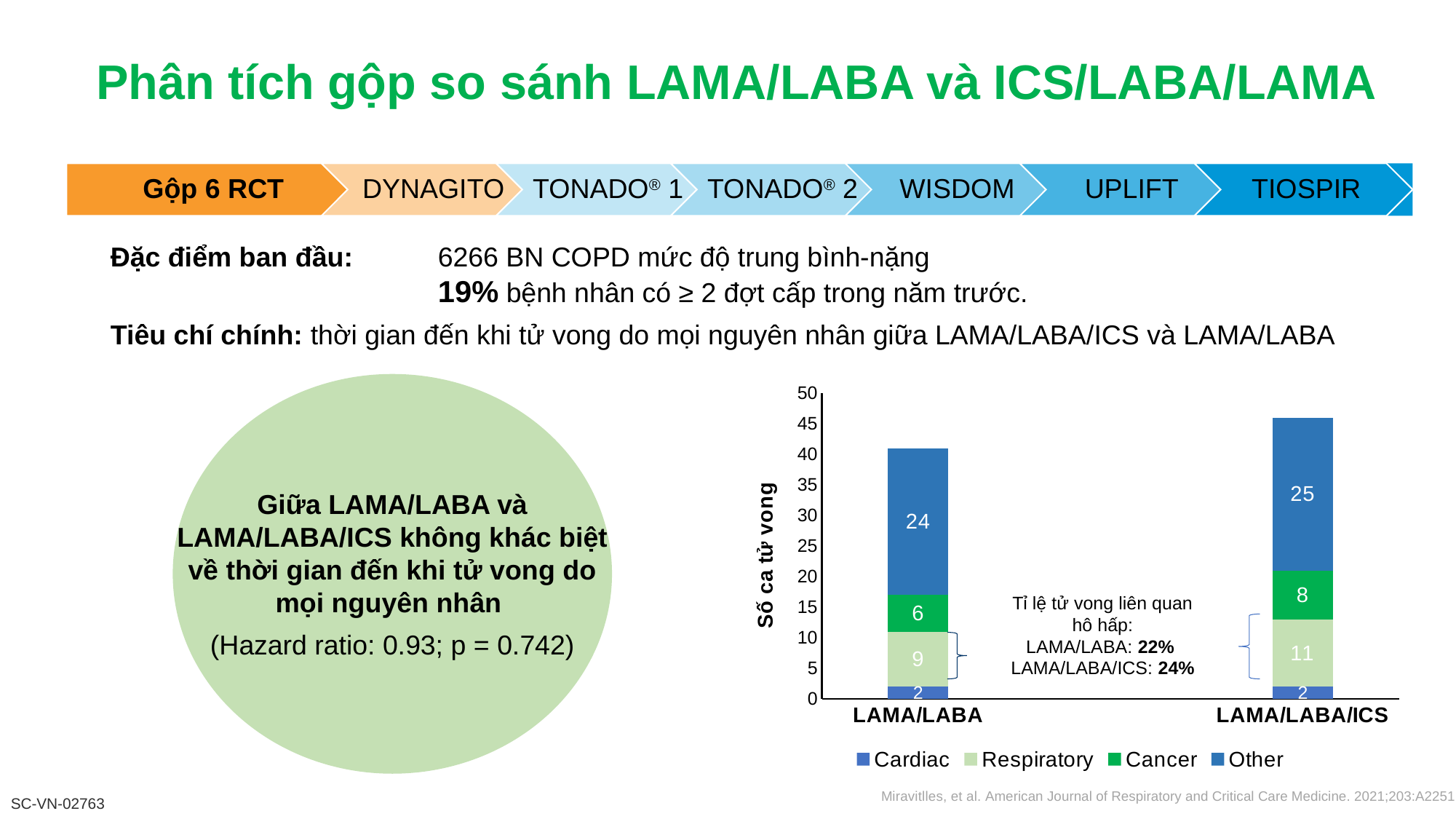
What is the difference between the Respiratory values for LAMA/LABA/ICS and LAMA/LABA? 2 What is the total of the stacked bar for LAMA/LABA? 41 What is the Cancer value for LAMA/LABA? 6 Which category has the larger Other value, LAMA/LABA or LAMA/LABA/ICS? LAMA/LABA/ICS What is the Respiratory value for LAMA/LABA/ICS? 11 What kind of chart is shown on the slide? Stacked bar chart How many series does the chart legend list? 4 What is the Other value for LAMA/LABA? 24 How many categories are shown on the x axis of the chart? 2 What is the Cardiac value for LAMA/LABA/ICS? 2 What is the total of the stacked bar for LAMA/LABA/ICS? 46 What is the label of the y axis of the chart? Số ca tử vong